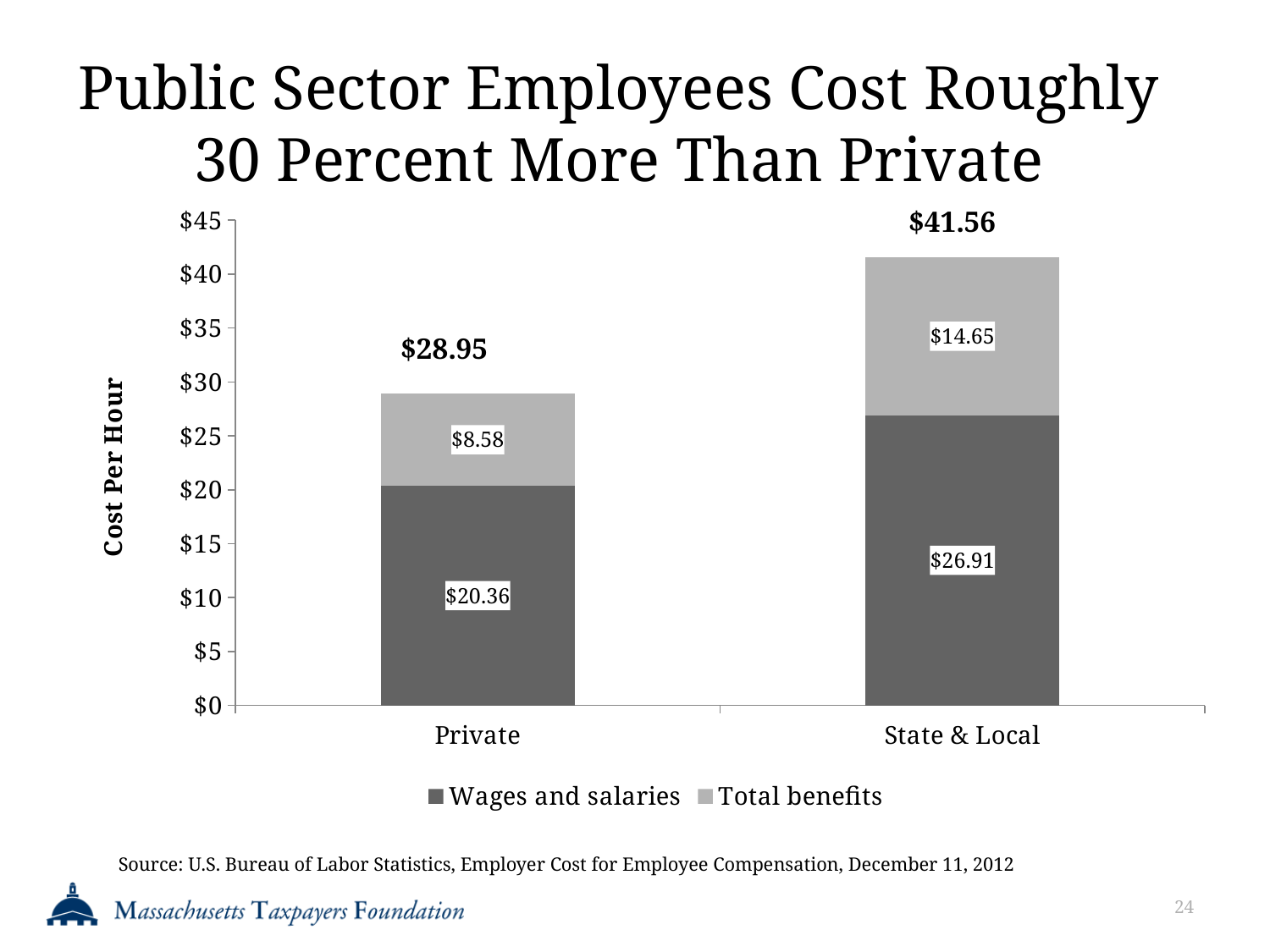
What is the Total benefits value for Private? $8.58 What is the total cost per hour for the Private bar? $28.95 Which category has the higher total cost per hour? State & Local How many series does the legend list? 2 What kind of chart is shown on the slide? Stacked bar chart What is the difference in Total benefits between State & Local and Private? $6.07 Which is larger: Wages and salaries for Private or Total benefits for State & Local? Wages and salaries for Private What is the difference in Wages and salaries between State & Local and Private? $6.55 What is the Total benefits value for State & Local? $14.65 What is the total cost per hour for the State & Local bar? $41.56 What is the Wages and salaries value for Private? $20.36 What is the Wages and salaries value for State & Local? $26.91